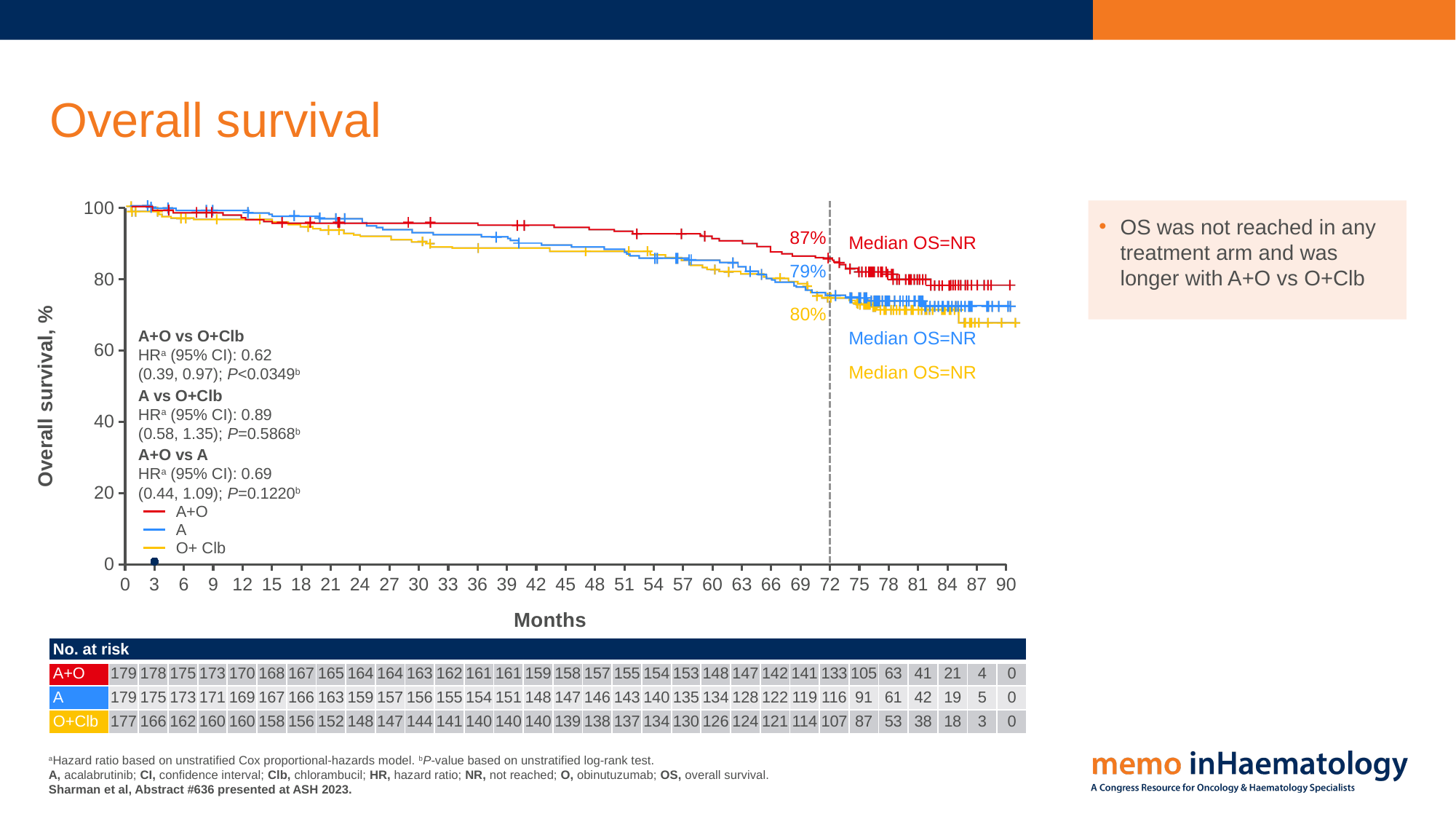
What is the overall survival rate for A+O at 72 months? 87% What is the overall survival rate for A at 72 months? 79% What is the overall survival rate for O+Clb at 72 months? 80% What is the difference in overall survival at 72 months between A+O and A? 8 percentage points How many treatment arms does the legend list? 3 Do the survival curves rise or fall as months increase? fall What is the median OS for the A+O arm? NR Which treatment arm has the highest overall survival rate at 72 months? A+O What kind of chart is shown on the slide? line chart Is the overall survival value for A+O at 60 months greater or less than 80? greater What is the label of the x axis? Months How many patients were at risk in the O+Clb arm at 0 months? 177